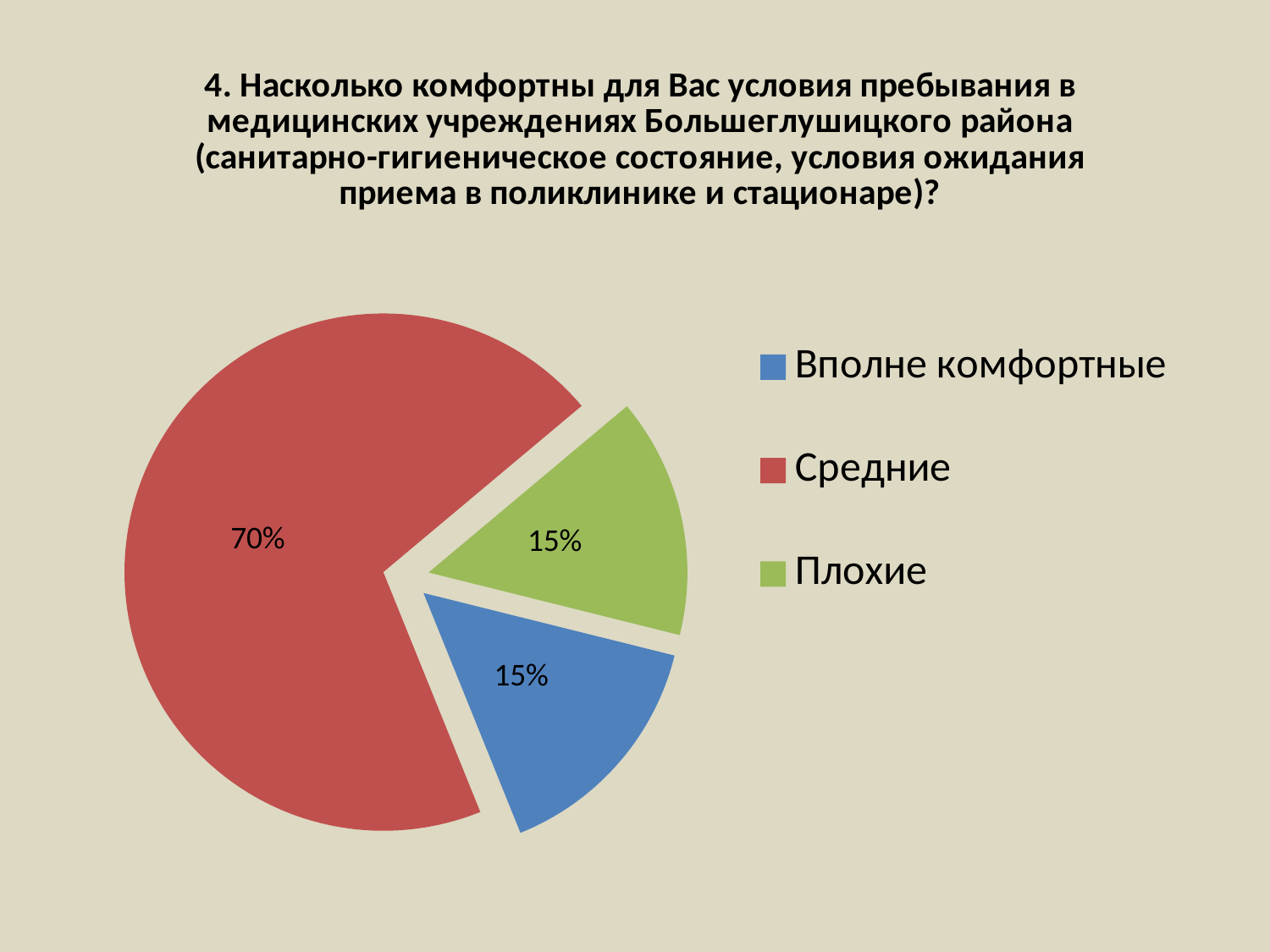
What share of the pie does the "Вполне комфортные" slice represent? 15% What share of the pie does the "Средние" slice represent? 70% Which is larger, the "Средние" slice or the "Вполне комфортные" slice? Средние How many slices does the pie chart have? 3 What colour is the "Вполне комфортные" slice in the pie chart? blue How many entries does the legend list? 3 What colour is the "Плохие" slice in the pie chart? green What is the difference between the "Средние" share and the "Плохие" share? 55% Which category has the largest slice of the pie? Средние What kind of chart is shown on the slide? pie chart What share of the pie does the "Плохие" slice represent? 15%